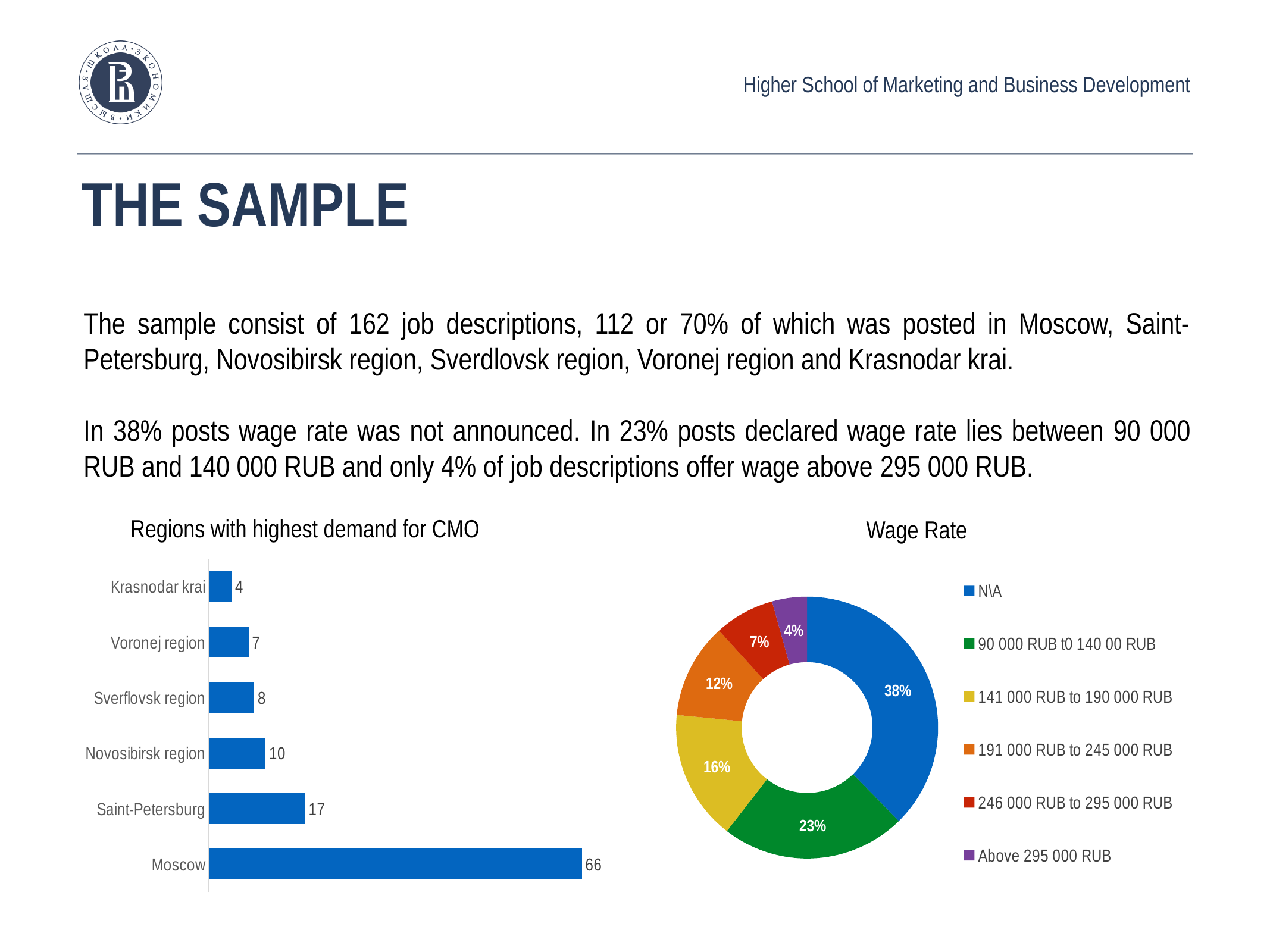
In the 'Regions with highest demand for CMO' chart, which region has the highest value? Moscow How many regions are shown in the 'Regions with highest demand for CMO' chart? 6 In the 'Regions with highest demand for CMO' chart, which is larger, the value for Novosibirsk region or Voronej region? Novosibirsk region What kind of chart is the 'Regions with highest demand for CMO' chart? Bar chart In the 'Regions with highest demand for CMO' chart, what is the difference between the values for Moscow and Saint-Petersburg? 49 In the 'Wage Rate' chart, what colour is the 'Above 295 000 RUB' slice? Purple In the 'Wage Rate' chart, what share of posts is labelled N\A? 38% In the 'Regions with highest demand for CMO' chart, which region has the lowest value? Krasnodar krai How many entries does the legend of the 'Wage Rate' chart list? 6 In the 'Regions with highest demand for CMO' chart, what is the value for Saint-Petersburg? 17 In the 'Regions with highest demand for CMO' chart, what is the value for Moscow? 66 In the 'Wage Rate' chart, what share of posts falls in the 141 000 RUB to 190 000 RUB range? 16%